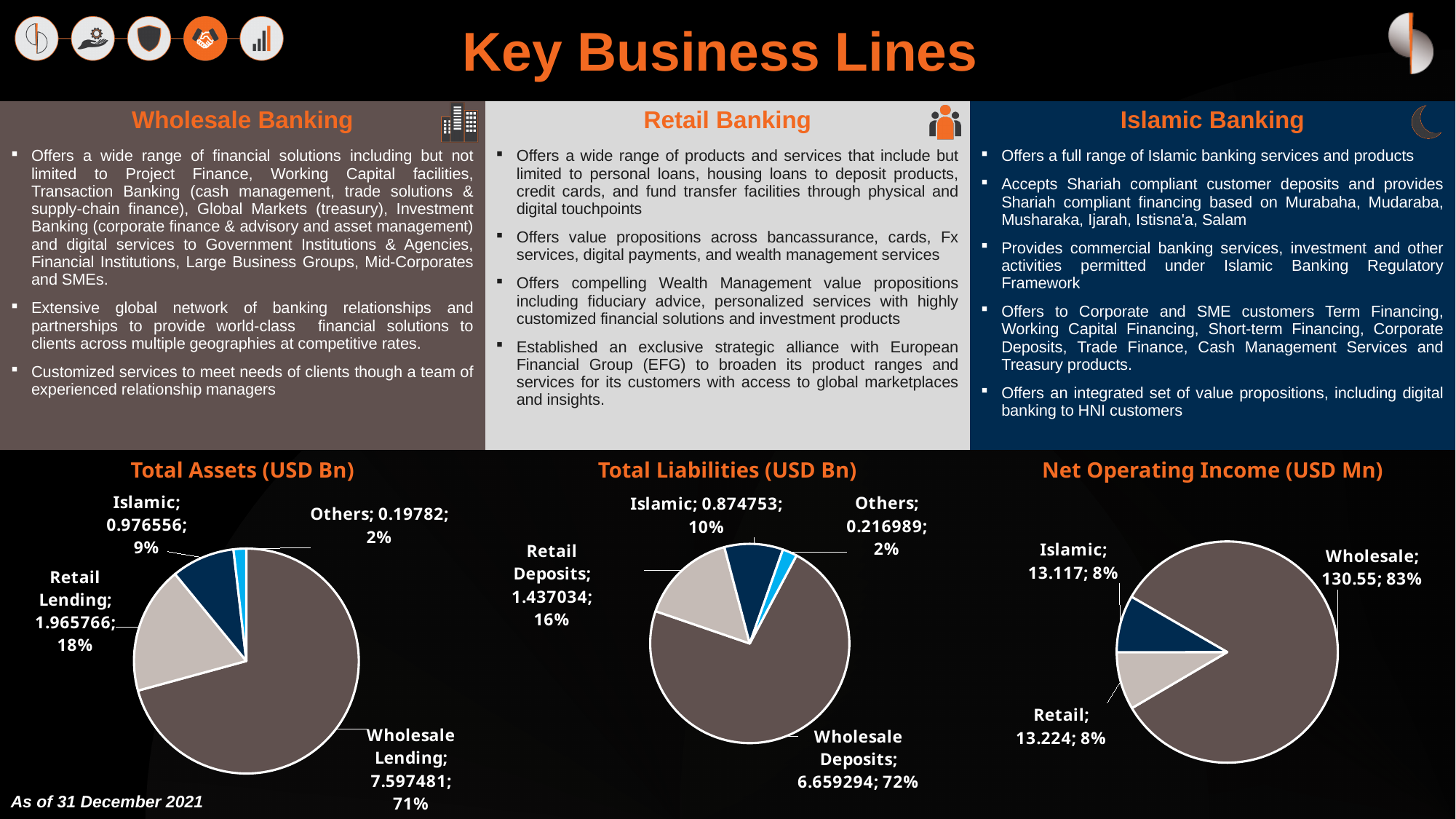
In the Total Assets (USD Bn) chart, what share of the pie does Islamic represent? 9% In the Net Operating Income (USD Mn) chart, how many categories are shown? 3 In the Total Liabilities (USD Bn) chart, which category has the smallest slice? Others In the Total Liabilities (USD Bn) chart, what is the value for Wholesale Deposits? 6.659294 In the Total Liabilities (USD Bn) chart, what share of the pie do Retail Deposits represent? 16% In the Total Assets (USD Bn) chart, what is the value for Retail Lending? 1.965766 In the Total Liabilities (USD Bn) chart, which is larger, Islamic or Others? Islamic In the Net Operating Income (USD Mn) chart, what is the value for Wholesale? 130.55 In the Total Assets (USD Bn) chart, how many slices does the pie have? 4 What type of chart is used for Net Operating Income (USD Mn)? Pie chart In the Net Operating Income (USD Mn) chart, what is the difference between Retail and Islamic? 0.107 In the Total Assets (USD Bn) chart, which category has the largest slice? Wholesale Lending